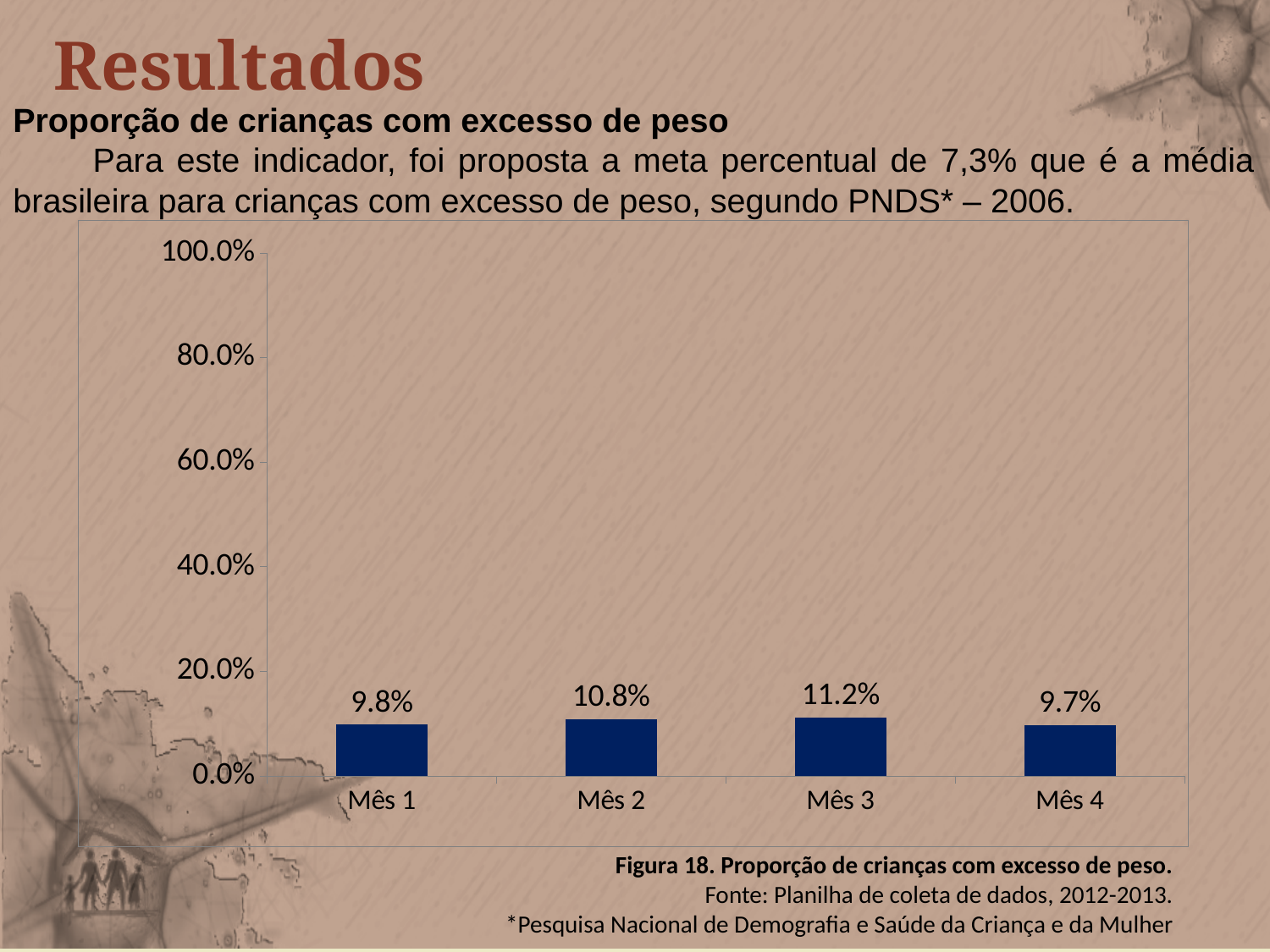
Which month has the lowest value? Mês 4 Which is larger, the value for Mês 2 or the value for Mês 4? Mês 2 What is the value for Mês 1? 9.8% Which month has the highest value? Mês 3 What is the value for Mês 3? 11.2% Is the value for Mês 3 greater or less than 20.0%? less How many months are shown on the x axis? 4 What kind of chart is shown on the slide? bar chart What is the difference between the values for Mês 3 and Mês 1? 1.4% What is the value for Mês 4? 9.7% What is the figure caption below the chart? Figura 18. Proporção de crianças com excesso de peso. What is the highest value shown on the y axis? 100.0%